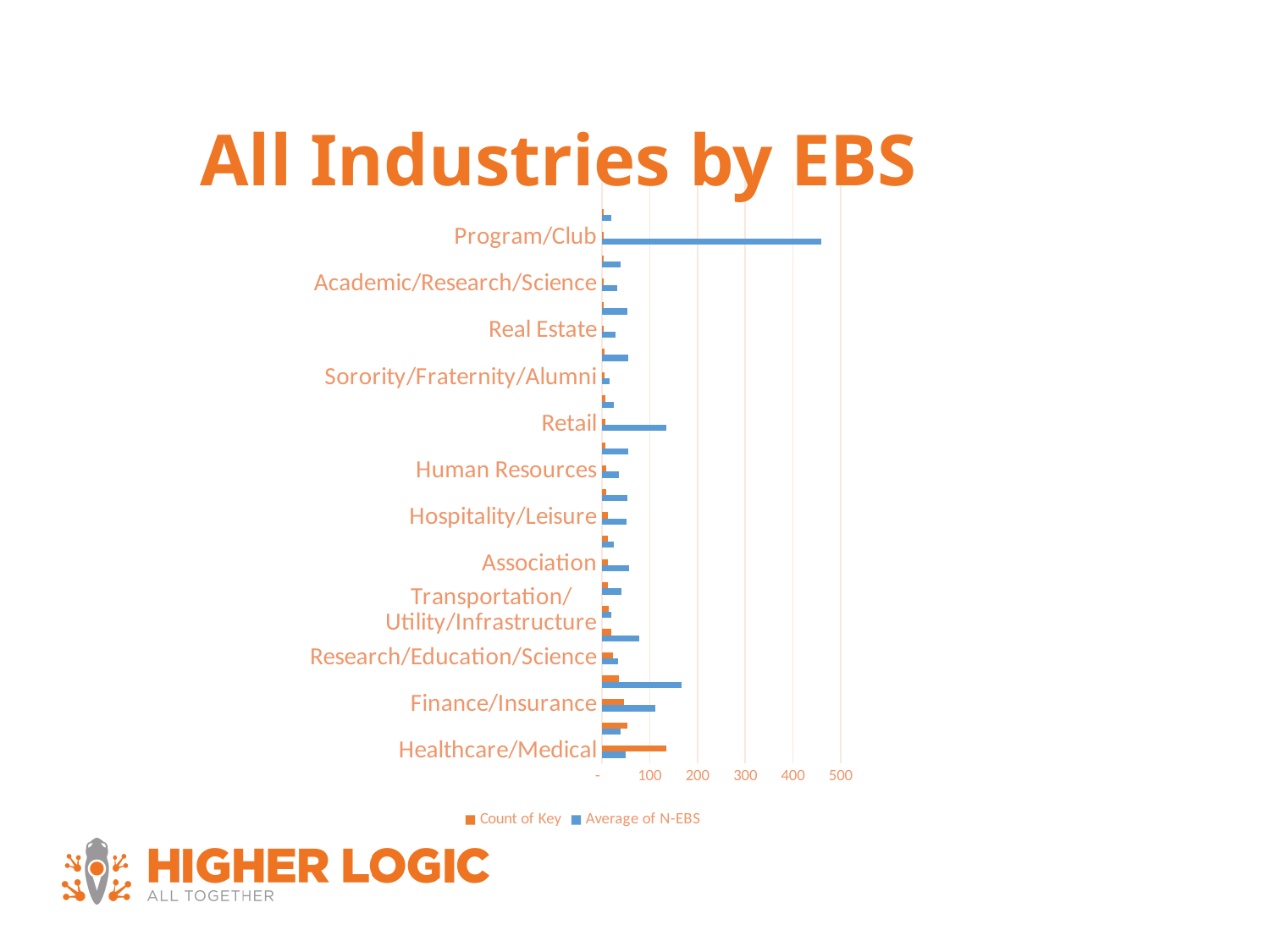
What kind of chart is shown on the slide? Bar chart Which category has the highest Average of N-EBS? Program/Club Is the Average of N-EBS for Program/Club greater or less than 400? greater Which is larger: the Average of N-EBS for Program/Club or for Retail? Program/Club How many series does the legend list? 2 Which series is shown in blue in the legend? Average of N-EBS Is the Count of Key for Finance/Insurance greater or less than 100? less What is the title of the chart? All Industries by EBS Is the Average of N-EBS for Retail greater or less than 100? greater Which is larger: the Count of Key for Healthcare/Medical or for Finance/Insurance? Healthcare/Medical